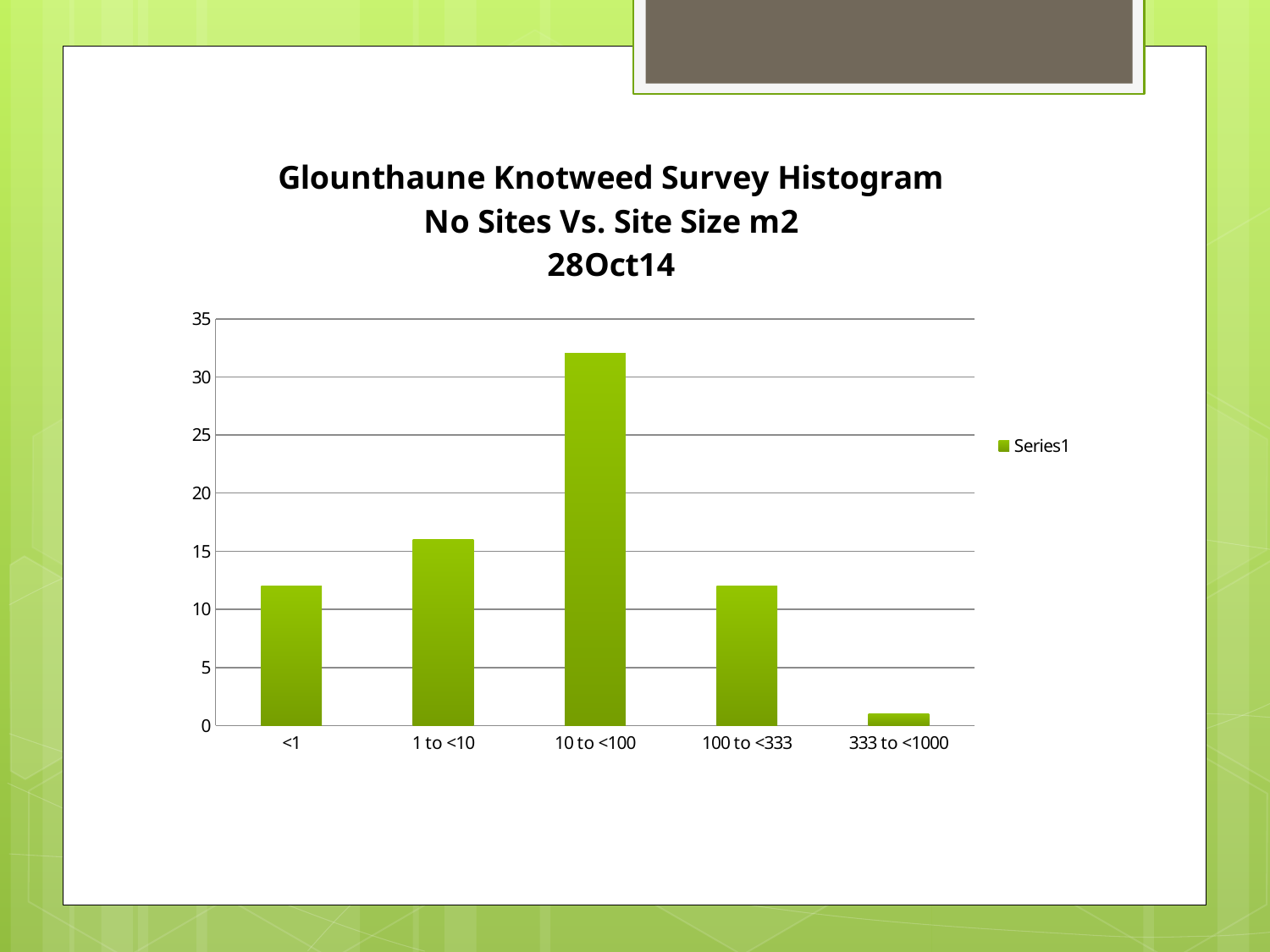
What is the name of the series listed in the legend? Series1 How many series does the legend list? 1 Which site size category has the highest number of sites? 10 to <100 Which site size category has the lowest number of sites? 333 to <1000 Is the value for 1 to <10 greater or less than 15? greater What kind of chart is shown on the slide? bar chart Is the value for 333 to <1000 greater or less than 5? less How many site size categories are shown on the x axis? 5 Do the values rise or fall from the 10 to <100 category to the 333 to <1000 category? fall Is the value for 10 to <100 greater or less than 30? greater Which has more sites, the <1 category or the 1 to <10 category? 1 to <10 Which has more sites, the 10 to <100 category or the 100 to <333 category? 10 to <100